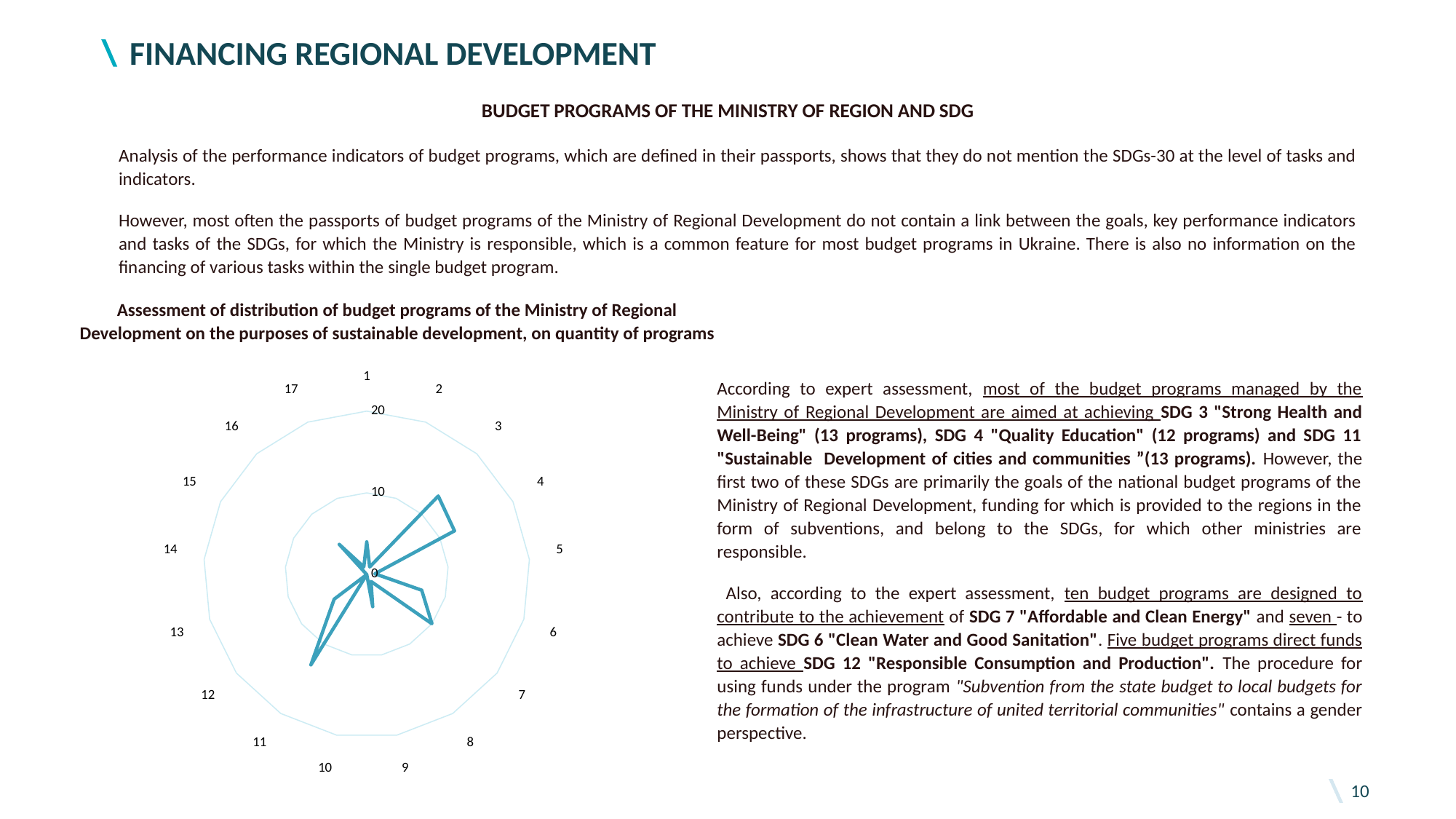
Is the value for category 11 greater or less than 10? greater What is the highest tick value shown on the radar chart's axis? 20 Is the value for category 12 greater or less than 10? less How many categories (axes) does the radar chart have? 17 What is the title of the chart? Assessment of distribution of budget programs of the Ministry of Regional Development on the purposes of sustainable development, on quantity of programs Which has the larger value, category 3 or category 6? category 3 Is the value for category 1 greater or less than 10? less What kind of chart is shown on the slide? radar chart Which has the larger value, category 11 or category 12? category 11